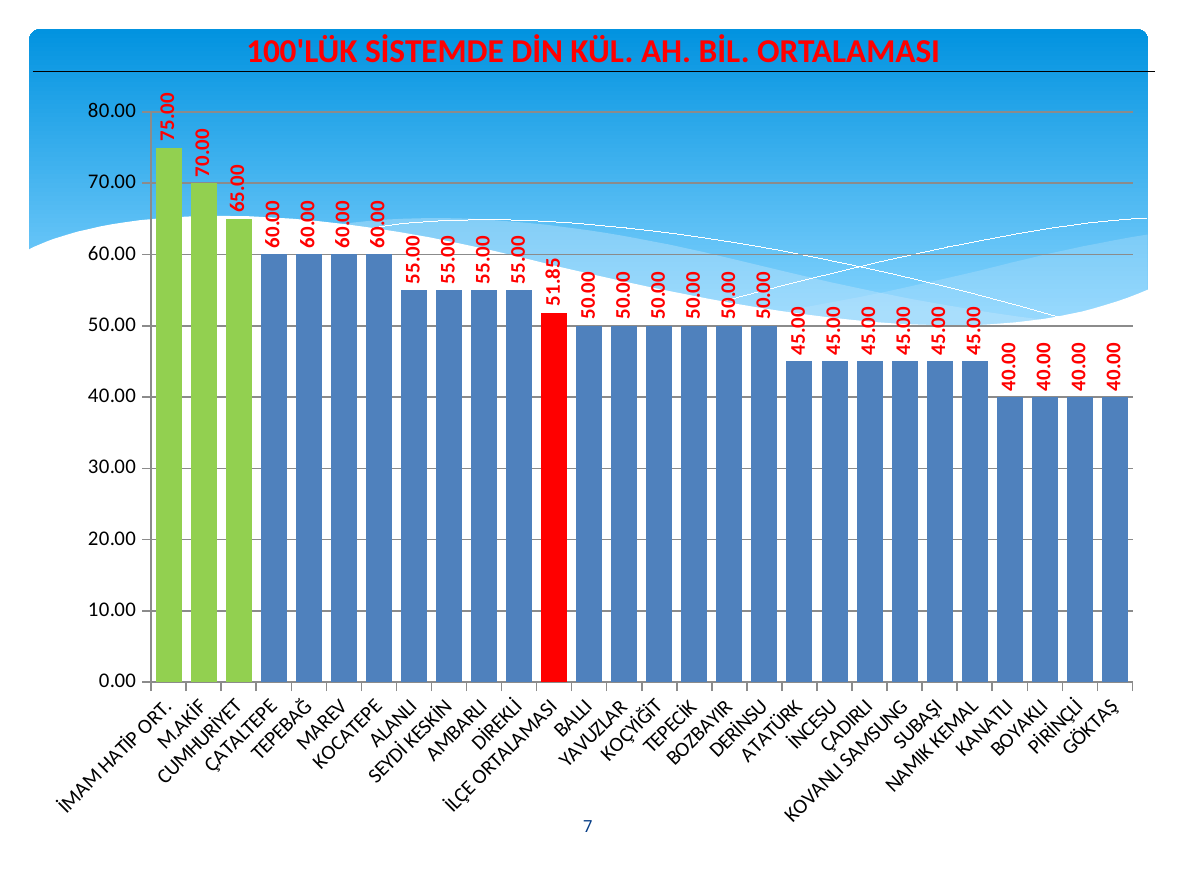
What is the title of the chart? 100'LÜK SİSTEMDE DİN KÜL. AH. BİL. ORTALAMASI What is the difference between the values for İMAM HATİP ORT. and GÖKTAŞ? 35.00 Do the values generally rise or fall from left to right along the x axis? fall Which is larger, the value for ÇATALTEPE or the value for ALANLI? ÇATALTEPE What is the difference between the values for M.AKİF and CUMHURİYET? 5.00 What is the value for KOVANLI SAMSUNG? 45.00 What is the value for İLÇE ORTALAMASI? 51.85 What is the value for İMAM HATİP ORT.? 75.00 Which category has the highest value? İMAM HATİP ORT. How many categories are shown on the x axis? 28 Is the value for BALLI greater or less than 60.00? less What kind of chart is shown on the slide? bar chart